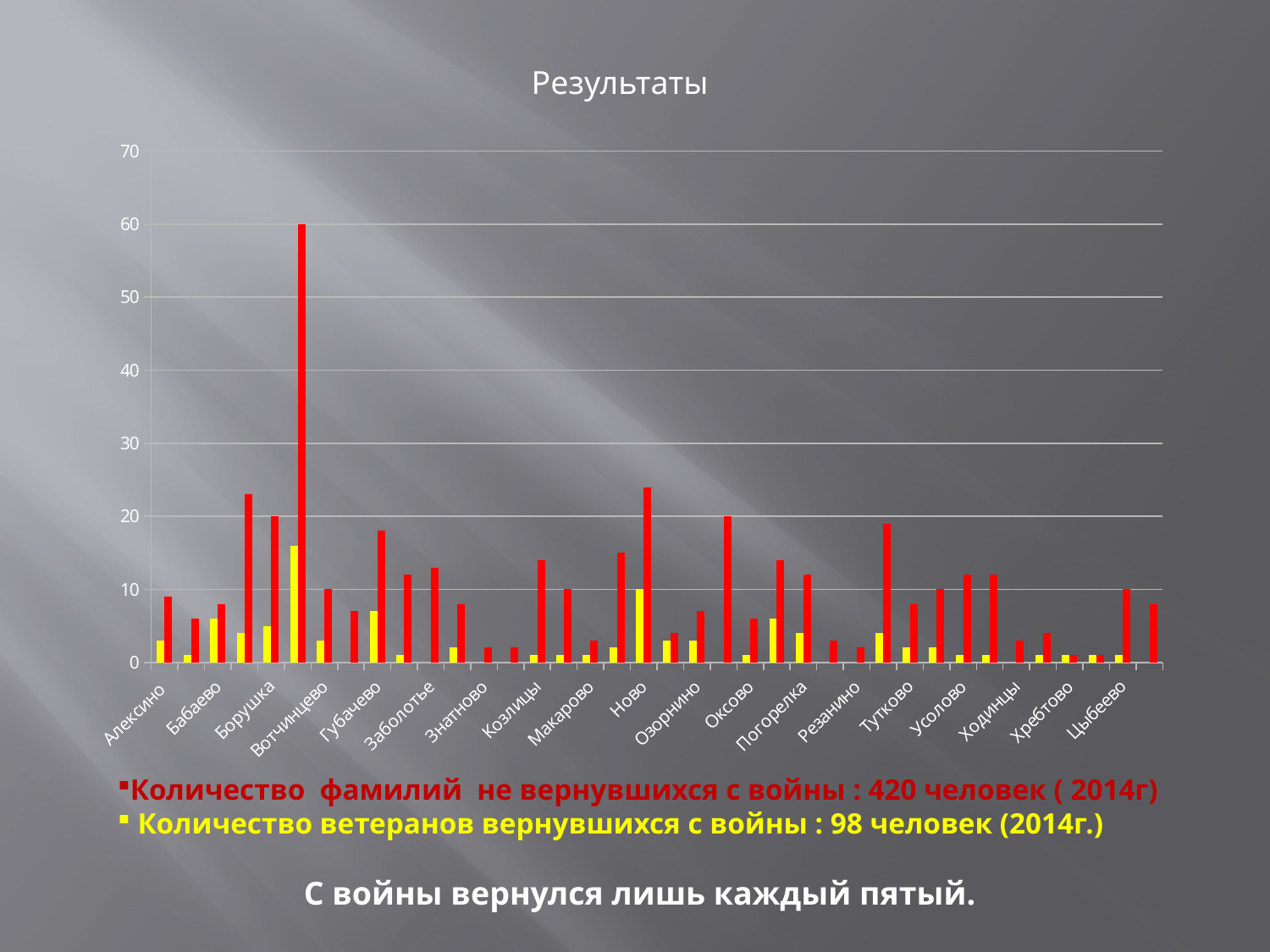
How many series does the chart show? 2 What is the title of the chart? Результаты Is the red bar for Губачево greater or less than 10? greater Is the red bar for Знатново greater or less than 10? less Is the yellow bar for Борушка greater or less than 10? less What kind of chart is shown on the slide? bar chart Which has the larger red bar, Губачево or Хребтово? Губачево Which has the larger red bar, Ново or Знатново? Ново Which colour represents the number of surnames of those who did not return from the war (Количество фамилий не вернувшихся с войны)? red